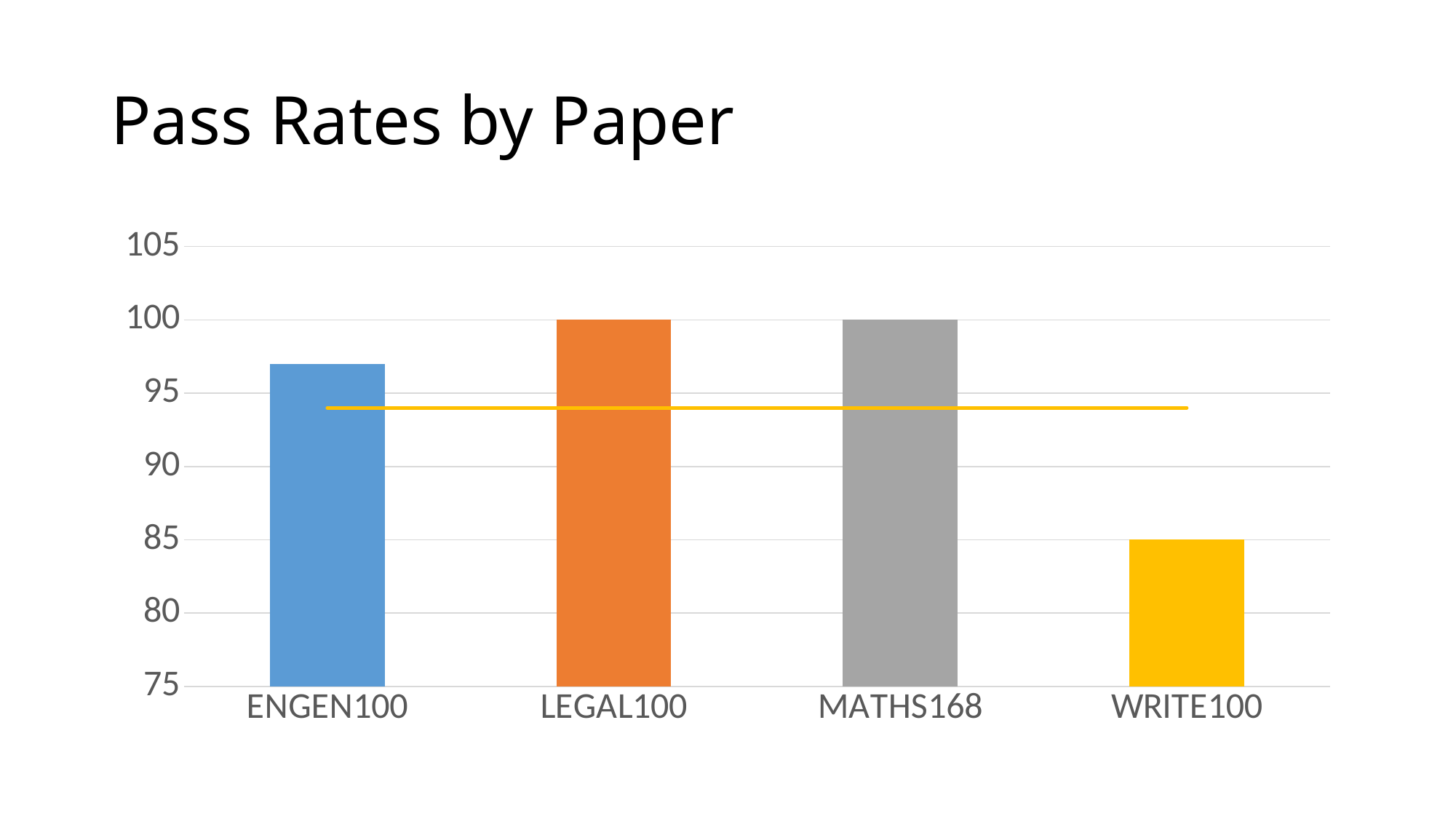
Which paper has the lowest pass rate? WRITE100 Which has the higher pass rate, ENGEN100 or WRITE100? ENGEN100 How many papers are shown on the x axis of the chart? 4 What is the pass rate for WRITE100? 85 What is the pass rate for MATHS168? 100 What kind of chart is shown on the slide? combination bar and line chart Is the pass rate for ENGEN100 greater or less than 95? greater What is the title of the chart? Pass Rates by Paper Is the horizontal line drawn across the chart above or below 90? above Is the pass rate for ENGEN100 greater or less than 100? less What is the pass rate for LEGAL100? 100 What is the difference between the pass rates of LEGAL100 and WRITE100? 15